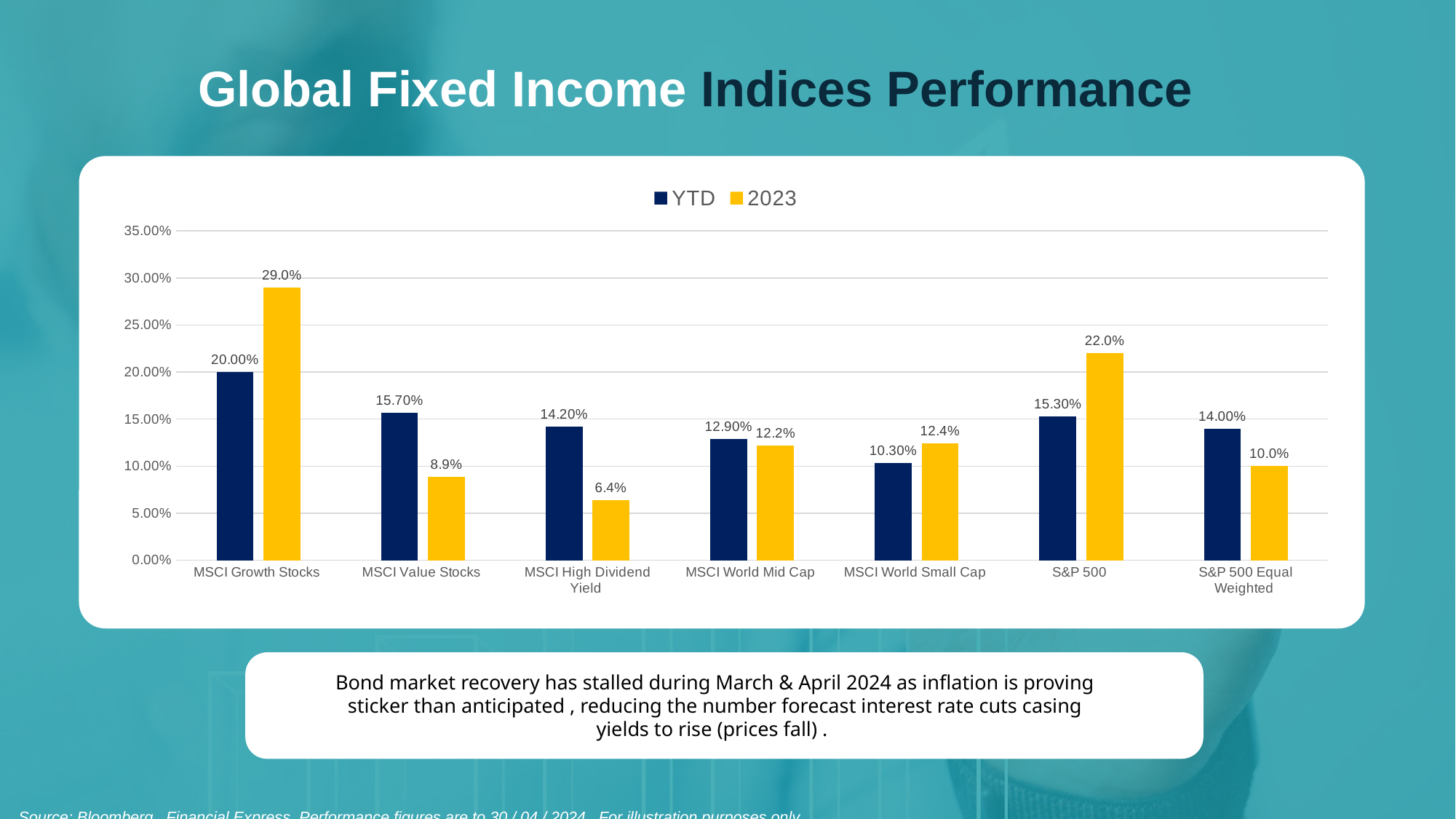
How many series does the legend list? 2 Which category has the lowest YTD value? MSCI World Small Cap What is the difference between the 2023 and YTD values for MSCI Growth Stocks? 9.0% What is the 2023 value for S&P 500? 22.0% What is the YTD value for S&P 500 Equal Weighted? 14.00% What kind of chart is shown on the slide? Bar chart Which colour represents the 2023 series in the legend? Yellow Which category has the highest 2023 value? MSCI Growth Stocks How many categories are shown on the x axis? 7 What is the YTD value for MSCI Growth Stocks? 20.00% Which is larger for MSCI Value Stocks, the YTD value or the 2023 value? YTD What is the 2023 value for MSCI High Dividend Yield? 6.4%